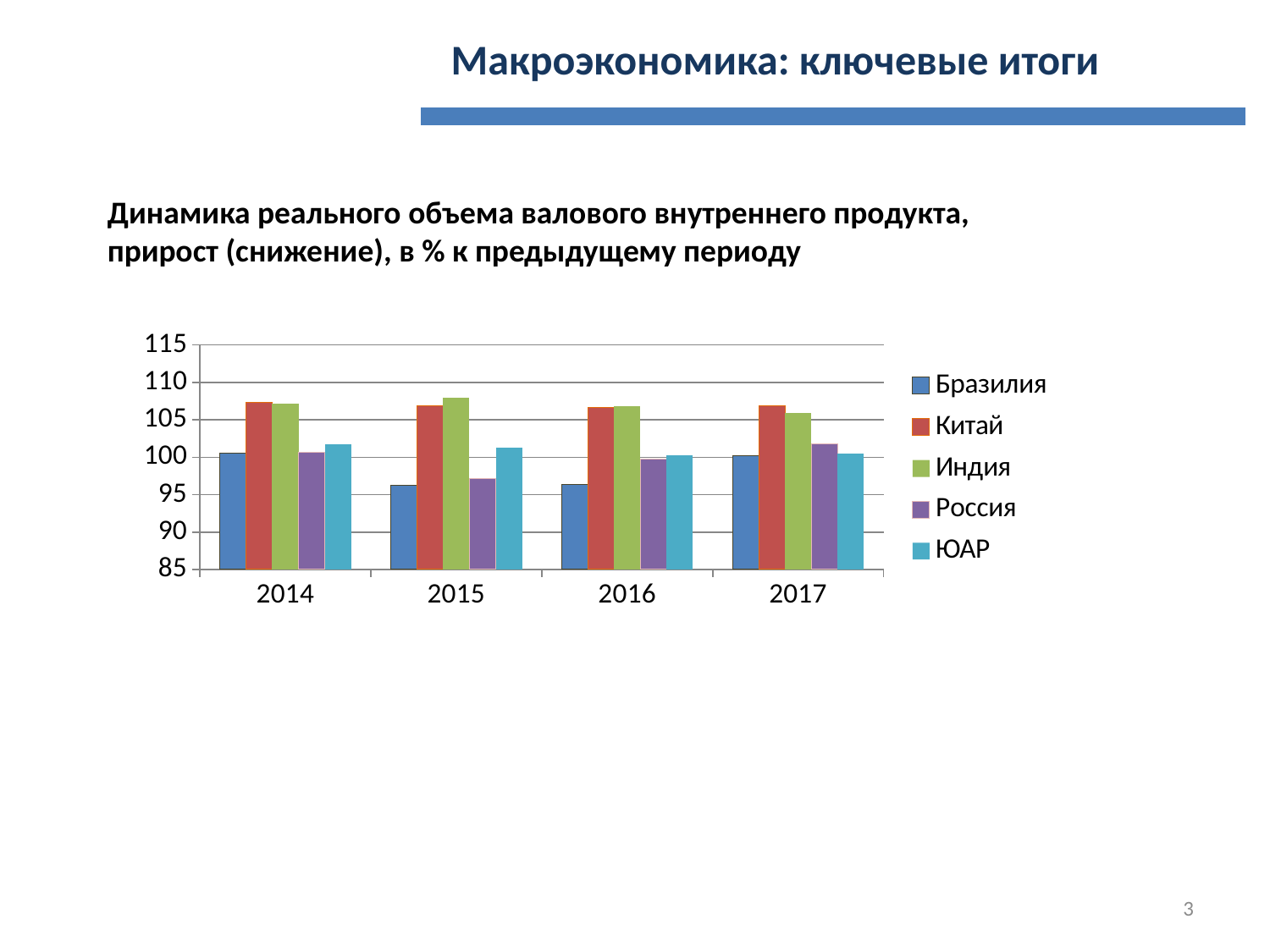
How many series does the legend list? 5 Is the value for Китай in 2014 greater or less than 105? greater What kind of chart is shown on the slide? bar chart Is the value for Бразилия in 2015 greater or less than 100? less Which is larger in 2015: the value for Индия or the value for Россия? Индия Is the value for Россия in 2015 greater or less than 100? less How many years are shown on the x axis? 4 Which series is shown in the legend with the light blue colour? ЮАР Which is larger in 2016: the value for Китай or the value for Бразилия? Китай Which series has the highest value in 2015? Индия Does the value for Бразилия rise or fall from 2014 to 2015? fall